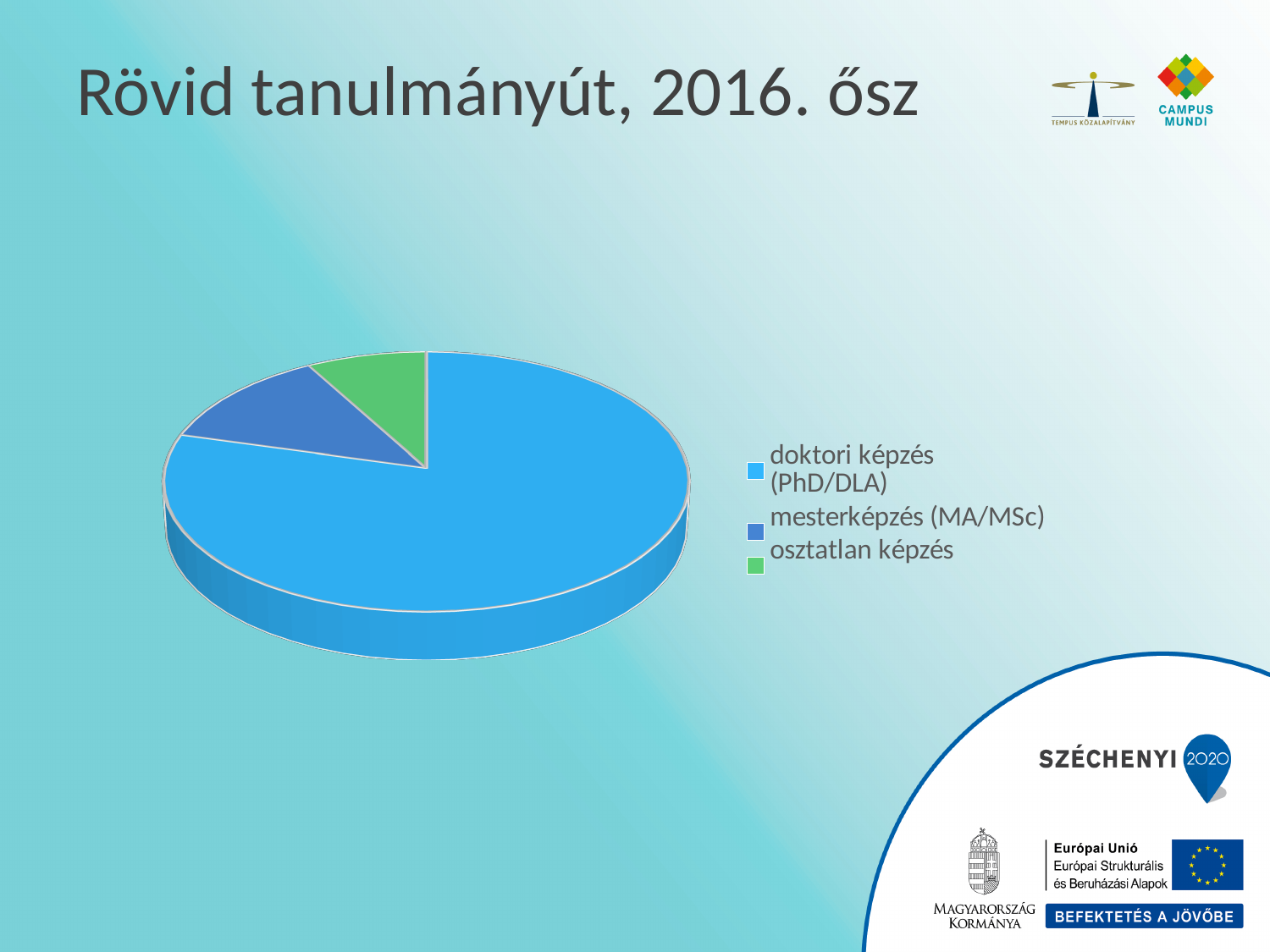
Which colour represents osztatlan képzés in the pie chart? green How many entries does the legend of the pie chart list? 3 Does the doktori képzés (PhD/DLA) slice make up more or less than half of the pie? more Which category has the smallest slice of the pie chart? osztatlan képzés How many slices does the pie chart have? 3 Which category has the largest slice of the pie chart? doktori képzés (PhD/DLA) Which slice is larger: doktori képzés (PhD/DLA) or mesterképzés (MA/MSc)? doktori képzés (PhD/DLA) Which slice is larger: mesterképzés (MA/MSc) or osztatlan képzés? mesterképzés (MA/MSc) What is the title of the slide containing the pie chart? Rövid tanulmányút, 2016. ősz What kind of chart is shown on the slide? pie chart